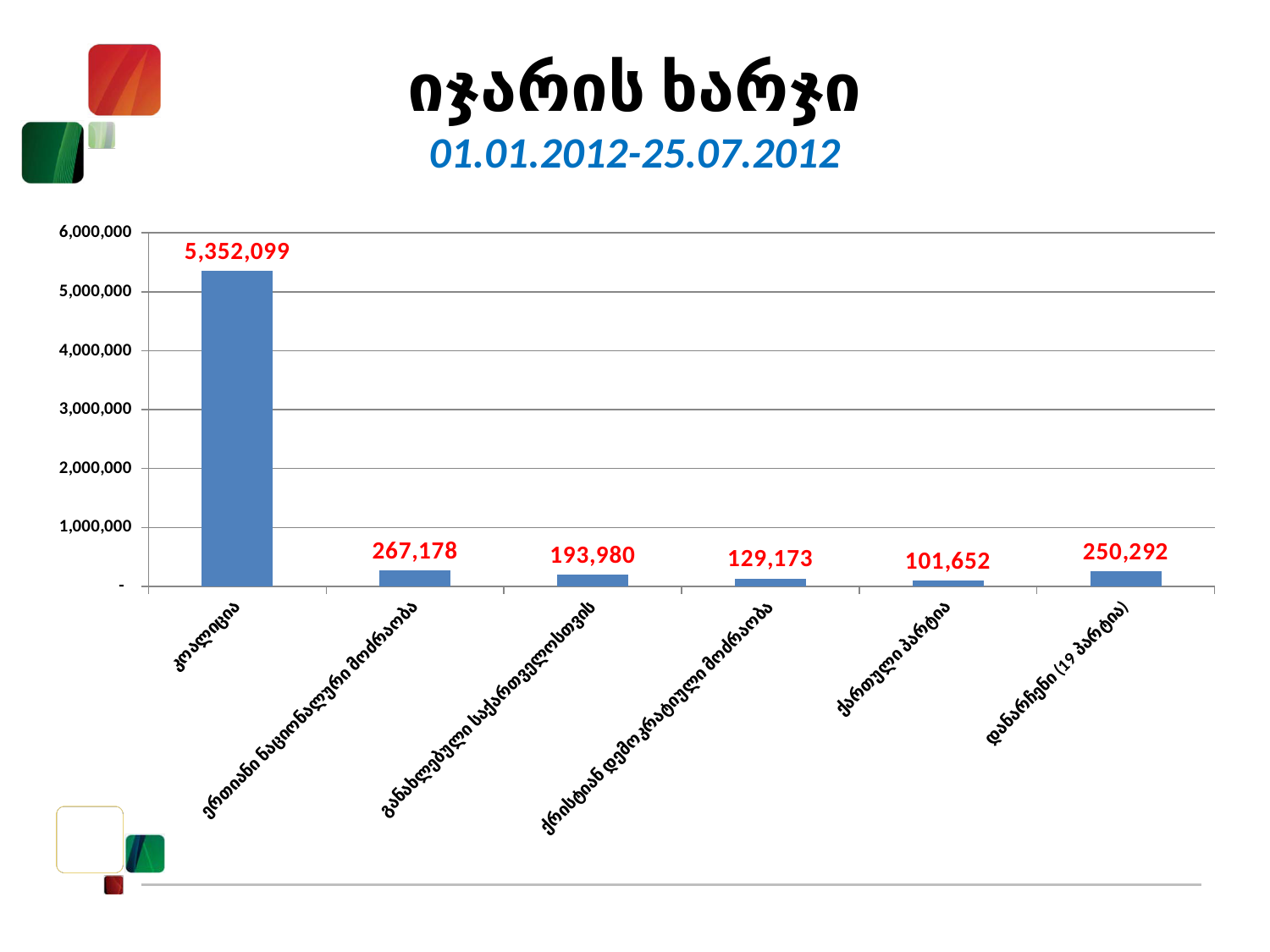
What period is given in the subtitle of the slide? 01.01.2012-25.07.2012 Which category has the lowest value? ქართული პარტია What is the value for ქრისტიან დემოკრატიული მოძრაობა? 129,173 Which category has the highest value? კოალიცია What is the difference between the values for ერთიანი ნაციონალური მოძრაობა and დანარჩენი (19 პარტია)? 16,886 Which is larger, the value for ქრისტიან დემოკრატიული მოძრაობა or the value for ქართული პარტია? ქრისტიან დემოკრატიული მოძრაობა How many categories are shown on the chart? 6 What is the value for ქართული პარტია? 101,652 What is the value for კოალიცია? 5,352,099 What kind of chart is shown on the slide? Bar chart What is the value for დანარჩენი (19 პარტია)? 250,292 What is the value for ერთიანი ნაციონალური მოძრაობა? 267,178